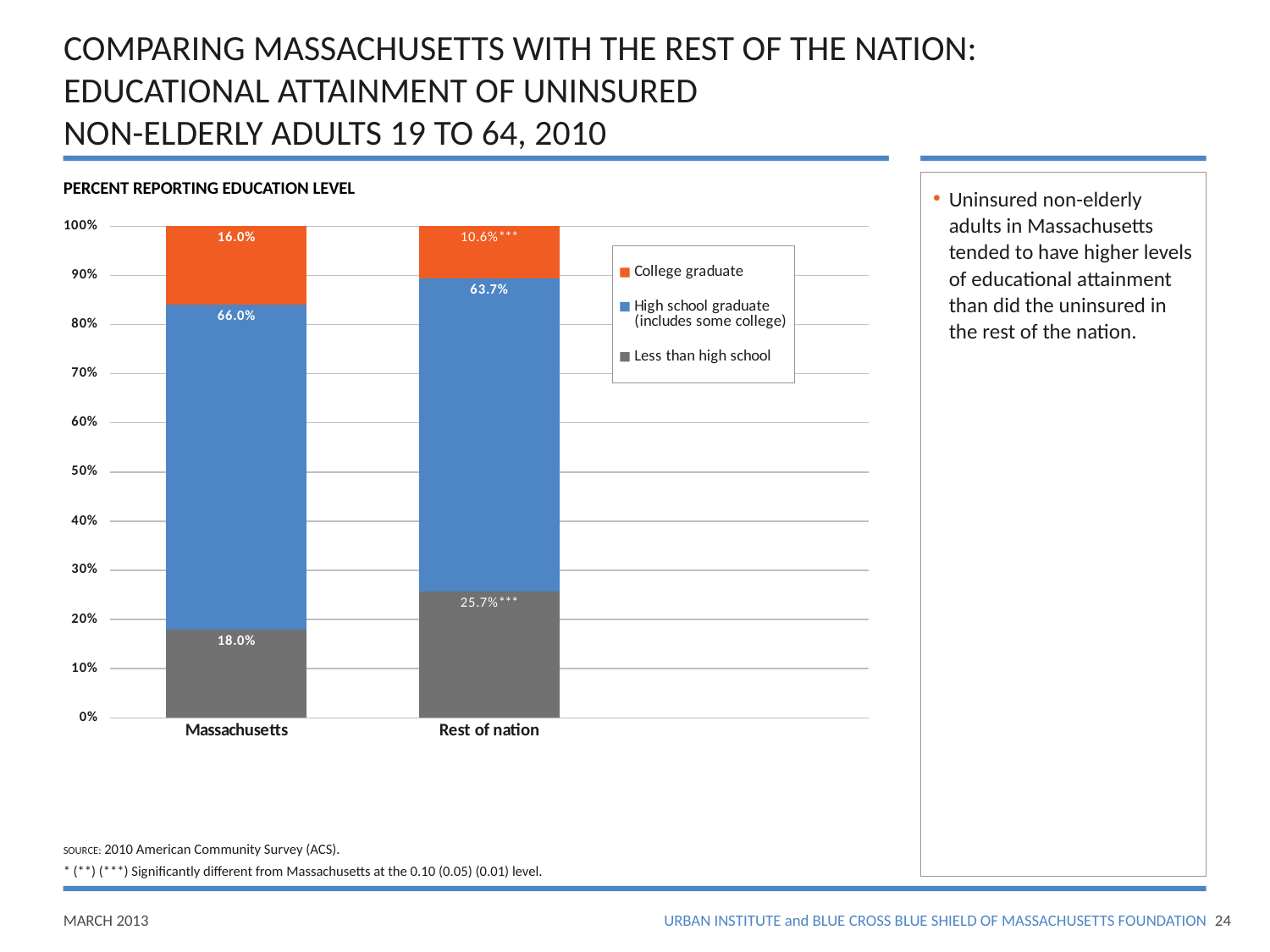
What percentage of uninsured non-elderly adults in the rest of the nation have less than high school education? 25.7% What percentage of uninsured non-elderly adults in Massachusetts are college graduates? 16.0% What is the difference in the college graduate share between Massachusetts and Rest of nation? 5.4 percentage points How many series does the legend list? 3 What is the value for college graduate for the rest of the nation? 10.6% Which colour represents the College graduate series in the legend? Orange What kind of chart is shown on the slide? Stacked bar chart Which category has the higher share of college graduates, Massachusetts or Rest of nation? Massachusetts Which category has the higher share with less than high school education? Rest of nation What is the difference in the less than high school share between Rest of nation and Massachusetts? 7.7 percentage points How many categories are shown on the x axis? 2 What is the value for high school graduate (includes some college) for Massachusetts? 66.0%